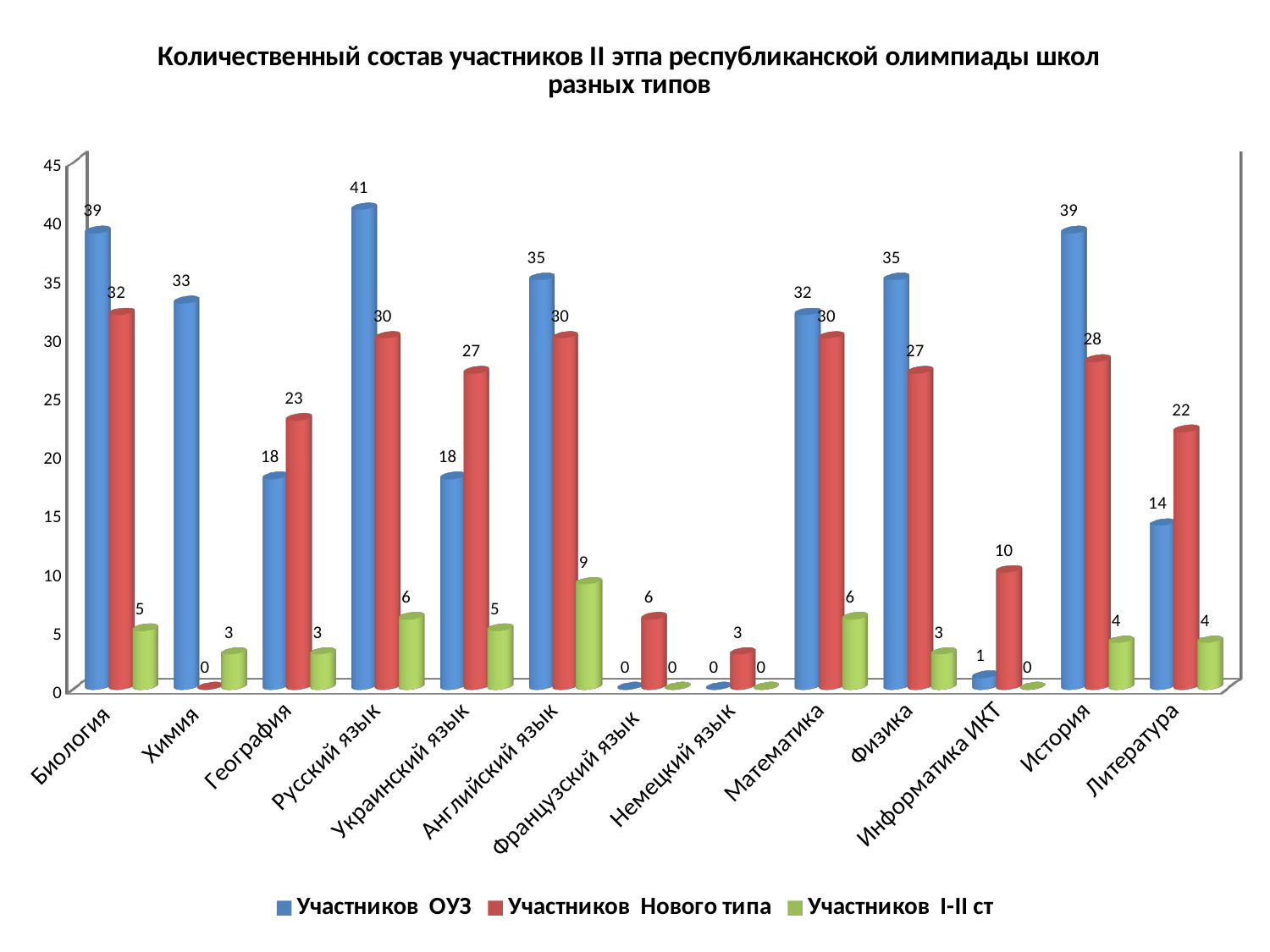
Which is larger in География: Участников ОУЗ or Участников Нового типа? Участников Нового типа Which category has the highest value for Участников Нового типа? Биология What is the value for Участников I-II ст in Английский язык? 9 Which category has the highest value for Участников ОУЗ? Русский язык What kind of chart is shown on the slide? Bar chart What is the total of the three series for Информатика ИКТ? 11 How many categories are shown on the x axis? 13 What is the value for Участников Нового типа in Литература? 22 Which category has the highest value for Участников I-II ст? Английский язык What is the difference between Участников ОУЗ and Участников Нового типа in Физика? 8 What is the value for Участников ОУЗ in Русский язык? 41 How many series does the legend list? 3